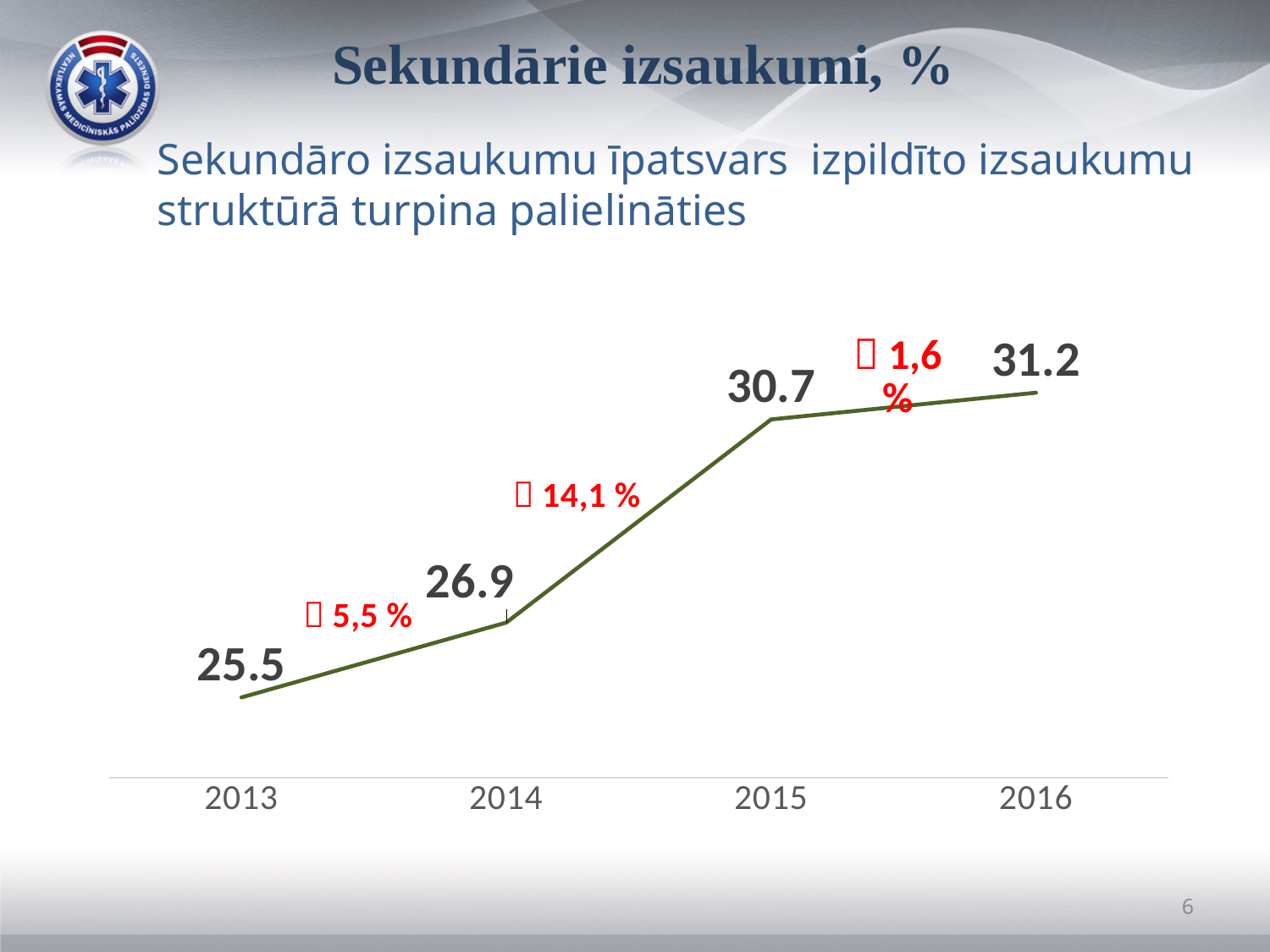
What is the value for 2013? 25.5 What is the value for 2016? 31.2 Which year has the highest value? 2016 What is the difference between the values for 2016 and 2013? 5.7 What is the value for 2015? 30.7 Do the values rise or fall from 2013 to 2016? rise What is the difference between the values for 2015 and 2014? 3.8 Which year has the lowest value? 2013 What kind of chart is shown on the slide? line chart What is the value for 2014? 26.9 How many years are plotted on the chart? 4 Which is larger, the value for 2014 or the value for 2015? 2015